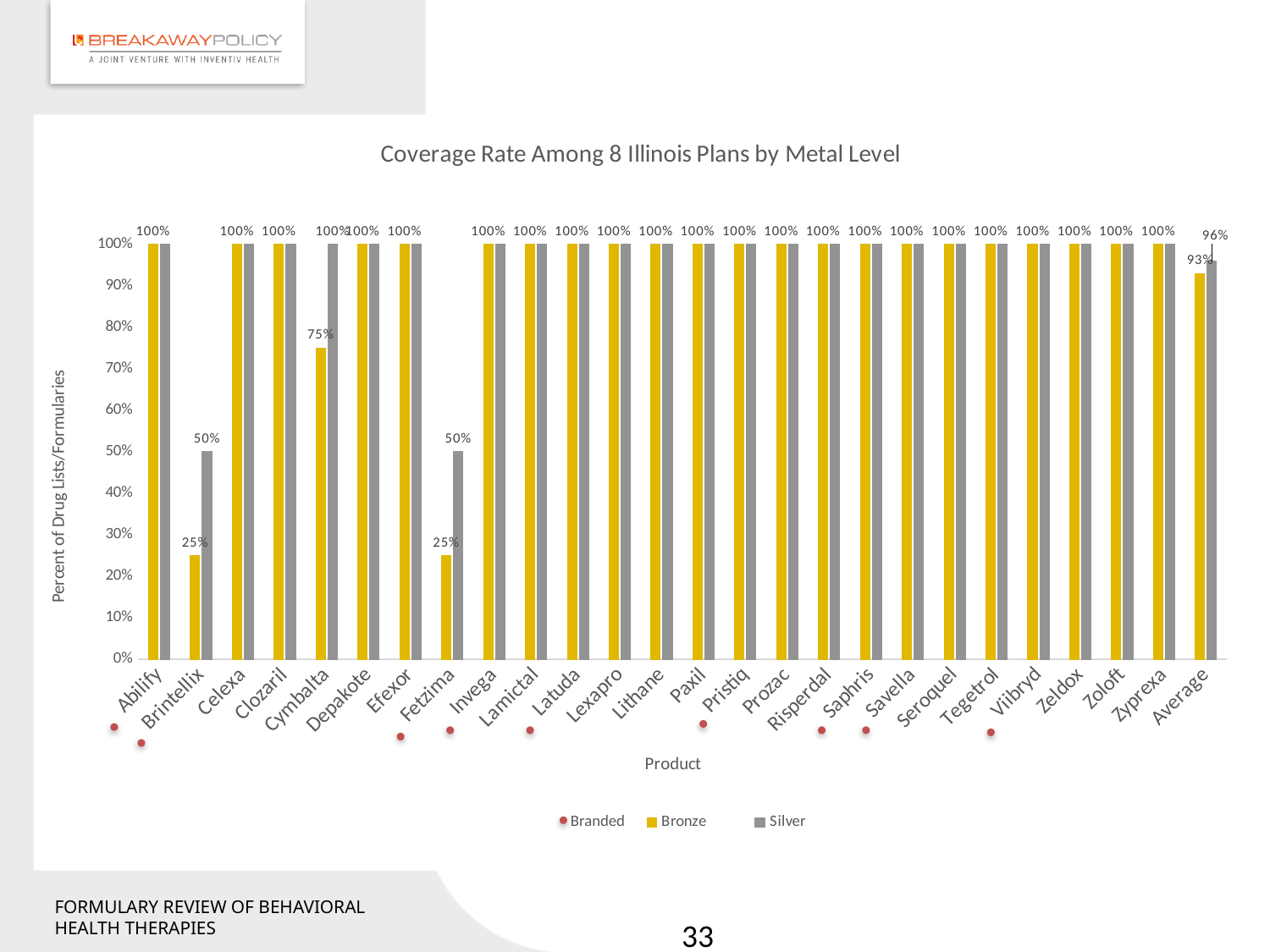
What is the Silver value for Fetzima? 50% What kind of chart is shown on the slide? bar chart For Cymbalta, which is larger, the Bronze value or the Silver value? Silver What is the title of the chart? Coverage Rate Among 8 Illinois Plans by Metal Level How many series does the legend list? 3 What is the difference between the Silver and Bronze values for Average? 3% What is the difference between the Silver and Bronze values for Brintellix? 25% What is the Bronze value for Brintellix? 25% What is the Silver value for Average? 96% What is the Bronze value for Average? 93% What is the Bronze value for Cymbalta? 75% How many products are shown on the x axis, including Average? 26